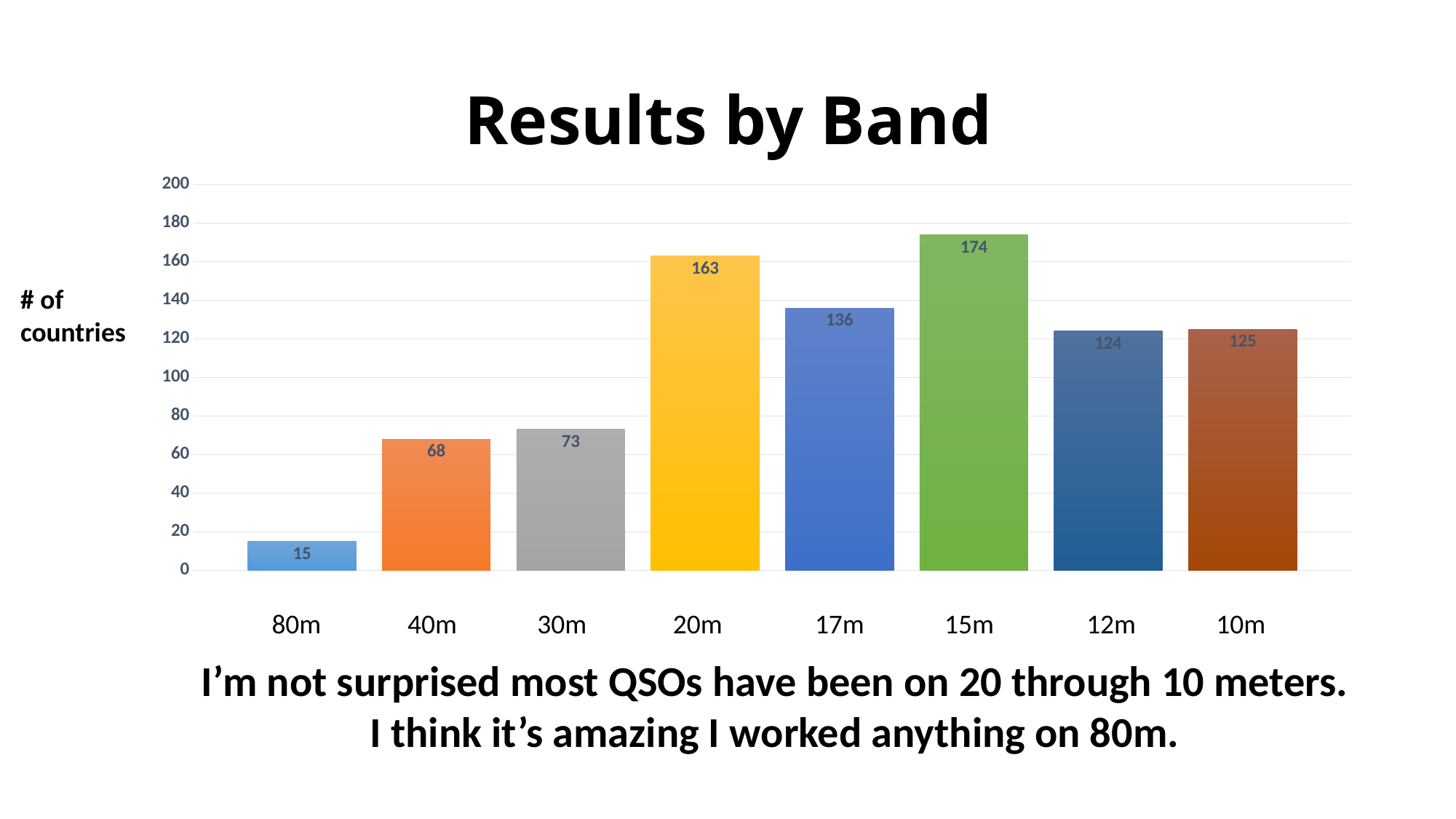
Which band has more countries, 17m or 12m? 17m What is the number of countries for the 80m band? 15 What is the number of countries for the 20m band? 163 How many bands are shown on the x axis? 8 What is the title of the chart? Results by Band Which band has the lowest number of countries? 80m What kind of chart is shown on the slide? bar chart What is the difference in number of countries between the 15m and 20m bands? 11 What is the number of countries for the 17m band? 136 Is the value for 40m greater or less than 80? less What is the difference in number of countries between the 30m and 40m bands? 5 Which band has the highest number of countries? 15m